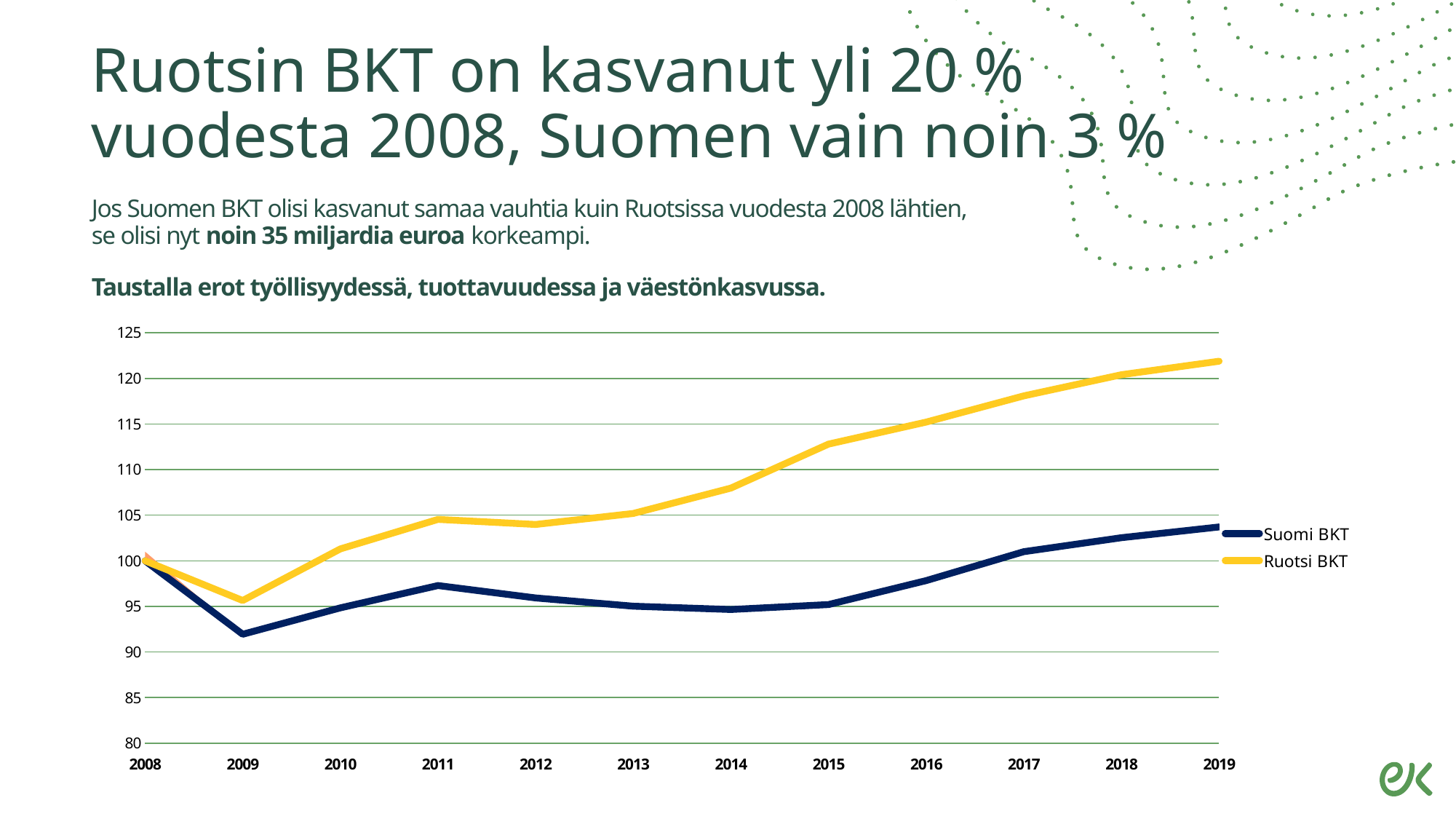
In 2015, which series has the higher value, Suomi BKT or Ruotsi BKT? Ruotsi BKT In which year is the Ruotsi BKT line at its highest? 2019 How many years are shown on the x axis of the chart? 12 What kind of chart is shown on the slide? line chart Is the value for Suomi BKT in 2009 greater or less than 95? less Is the value for Ruotsi BKT in 2009 greater or less than 100? less Is the value for Ruotsi BKT in 2015 greater or less than 110? greater Does the Ruotsi BKT line rise or fall from 2012 to 2019? rise Which series is drawn in yellow in the chart? Ruotsi BKT In which year is the Suomi BKT line at its lowest? 2009 How many series does the chart legend list? 2